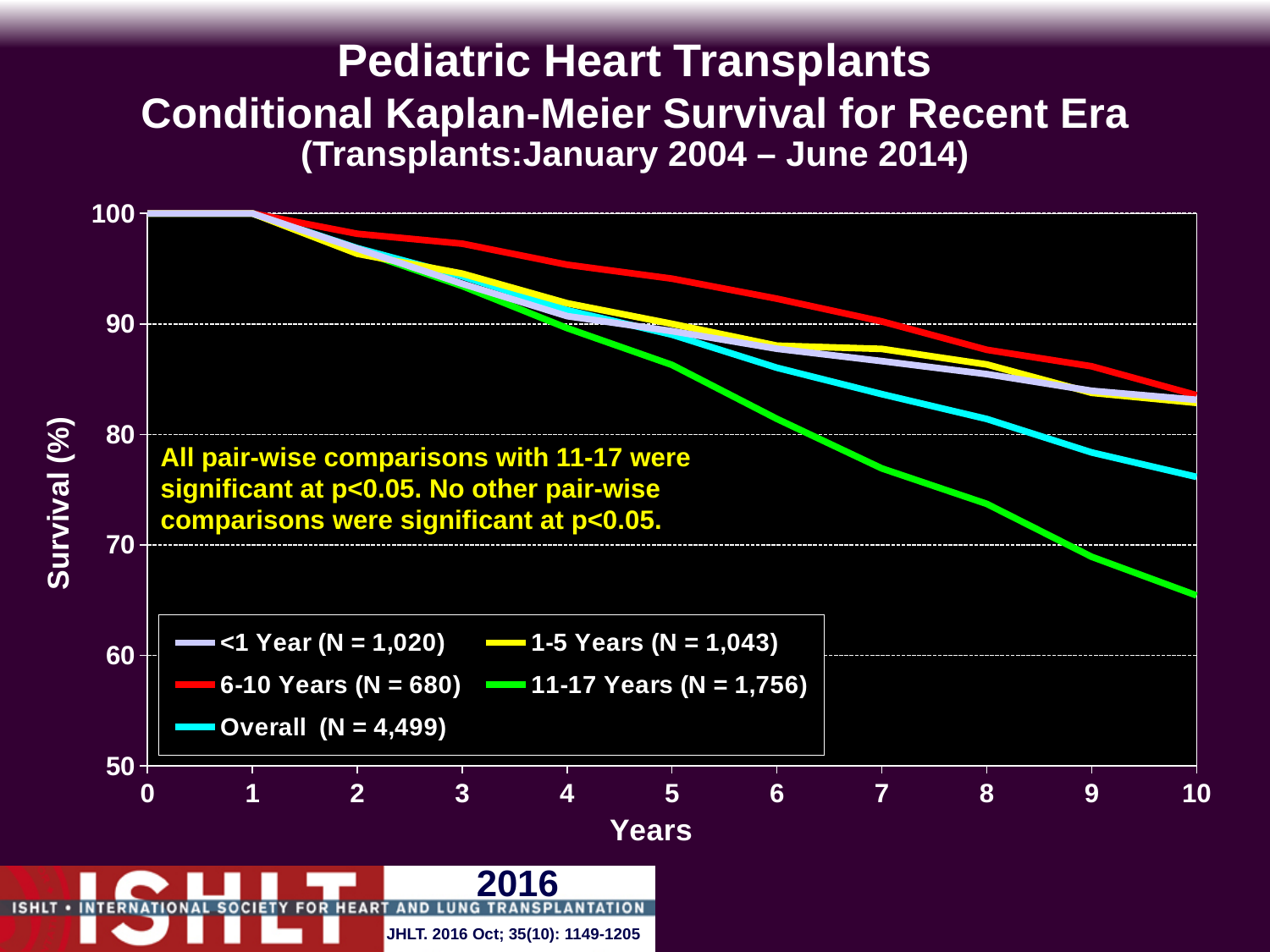
What is the N shown in the legend for the Overall series? 4,499 Is the survival for Overall at year 10 greater or less than 80? less Which series has the lowest survival at year 10? 11-17 Years Do the survival curves rise or fall as the years increase? Fall Is the survival for 11-17 Years at year 10 greater or less than 70? less Is the survival for 11-17 Years at year 8 greater or less than 80? less How many series does the legend list? 5 What kind of chart is shown on the slide? Line chart Which series has the highest survival at year 5? 6-10 Years At year 10, which is larger: the survival for 6-10 Years or for 11-17 Years? 6-10 Years What is the label of the x axis? Years